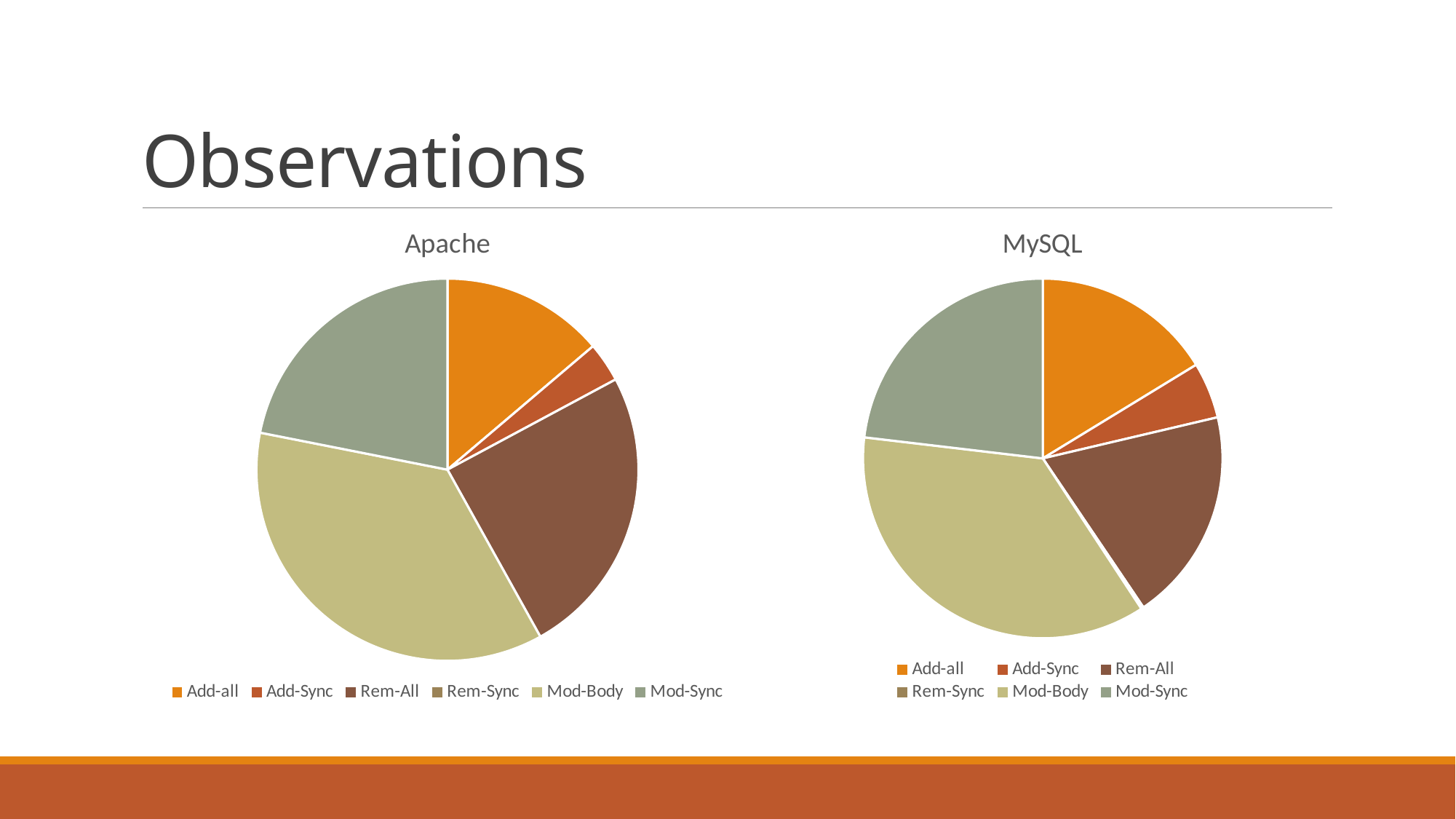
What kind of chart is the Apache chart? Pie chart What is the title of the pie chart on the right of the slide? MySQL In the MySQL chart, which category has the largest slice? Mod-Body In the Apache chart, which slice is larger, Mod-Sync or Add-all? Mod-Sync How many entries does the legend of the MySQL chart list? 6 In the Apache chart, which category has the largest slice? Mod-Body How many entries does the legend of the Apache chart list? 6 What kind of chart is the MySQL chart? Pie chart In the Apache chart, which slice is larger, Rem-All or Add-all? Rem-All In the MySQL chart, which slice is larger, Rem-All or Add-Sync? Rem-All What is the title of the pie chart on the left of the slide? Apache